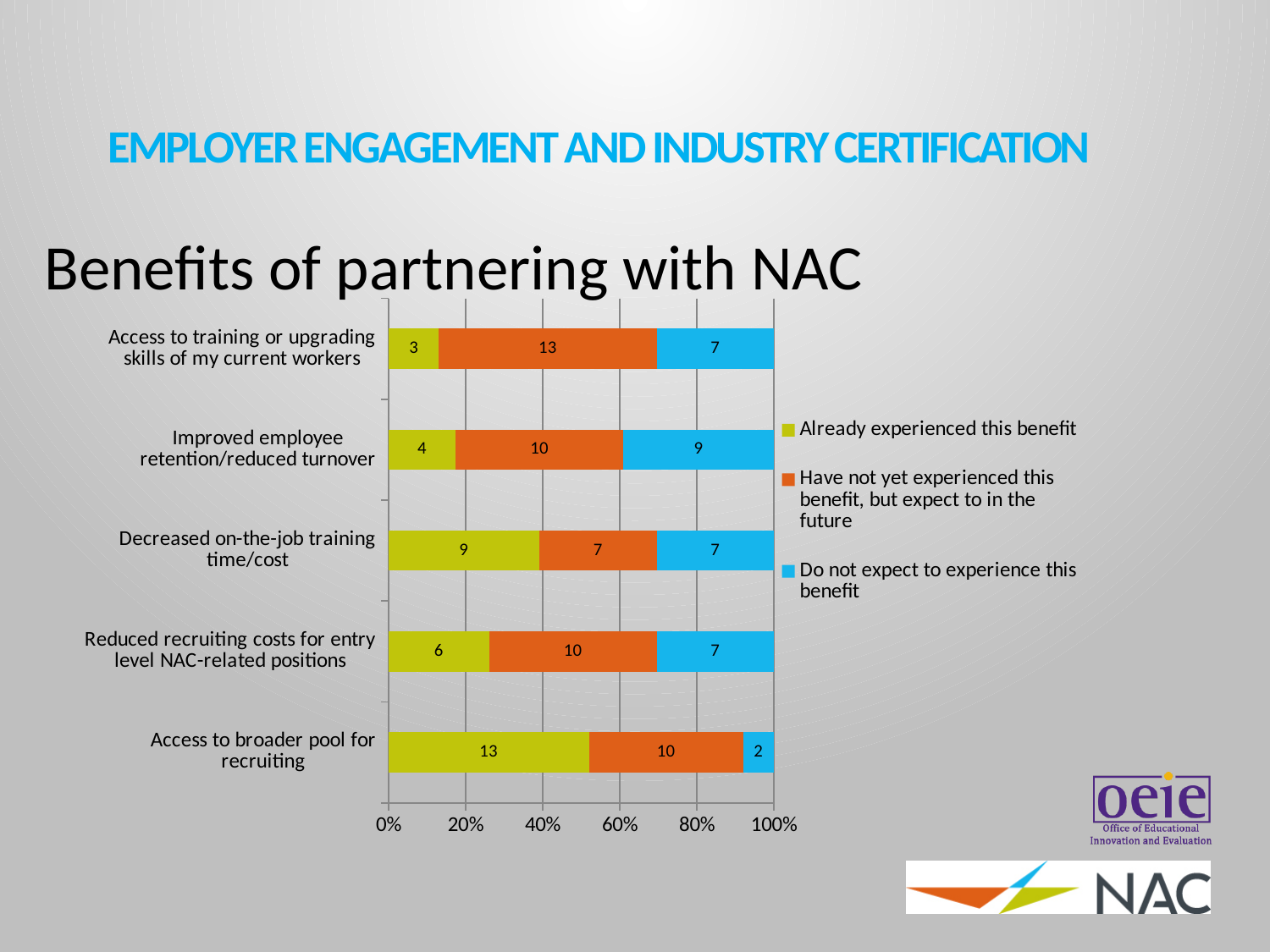
What is the value for 'Do not expect to experience this benefit' for 'Improved employee retention/reduced turnover'? 9 What kind of chart is shown on the slide? Stacked bar chart Which is larger: the 'Already experienced this benefit' value for 'Reduced recruiting costs for entry level NAC-related positions' or for 'Improved employee retention/reduced turnover'? Reduced recruiting costs for entry level NAC-related positions What is the title of the chart? Benefits of partnering with NAC What is the value for 'Have not yet experienced this benefit, but expect to in the future' for 'Access to training or upgrading skills of my current workers'? 13 What is the total of the three values in the bar for 'Access to broader pool for recruiting'? 25 What is the difference between the 'Already experienced this benefit' values for 'Decreased on-the-job training time/cost' and 'Access to training or upgrading skills of my current workers'? 6 How many categories (benefits) are plotted in the chart? 5 How many series does the legend list? 3 Which category has the highest value for 'Already experienced this benefit'? Access to broader pool for recruiting What is the value for 'Already experienced this benefit' for 'Access to broader pool for recruiting'? 13 Which category has the lowest value for 'Do not expect to experience this benefit'? Access to broader pool for recruiting